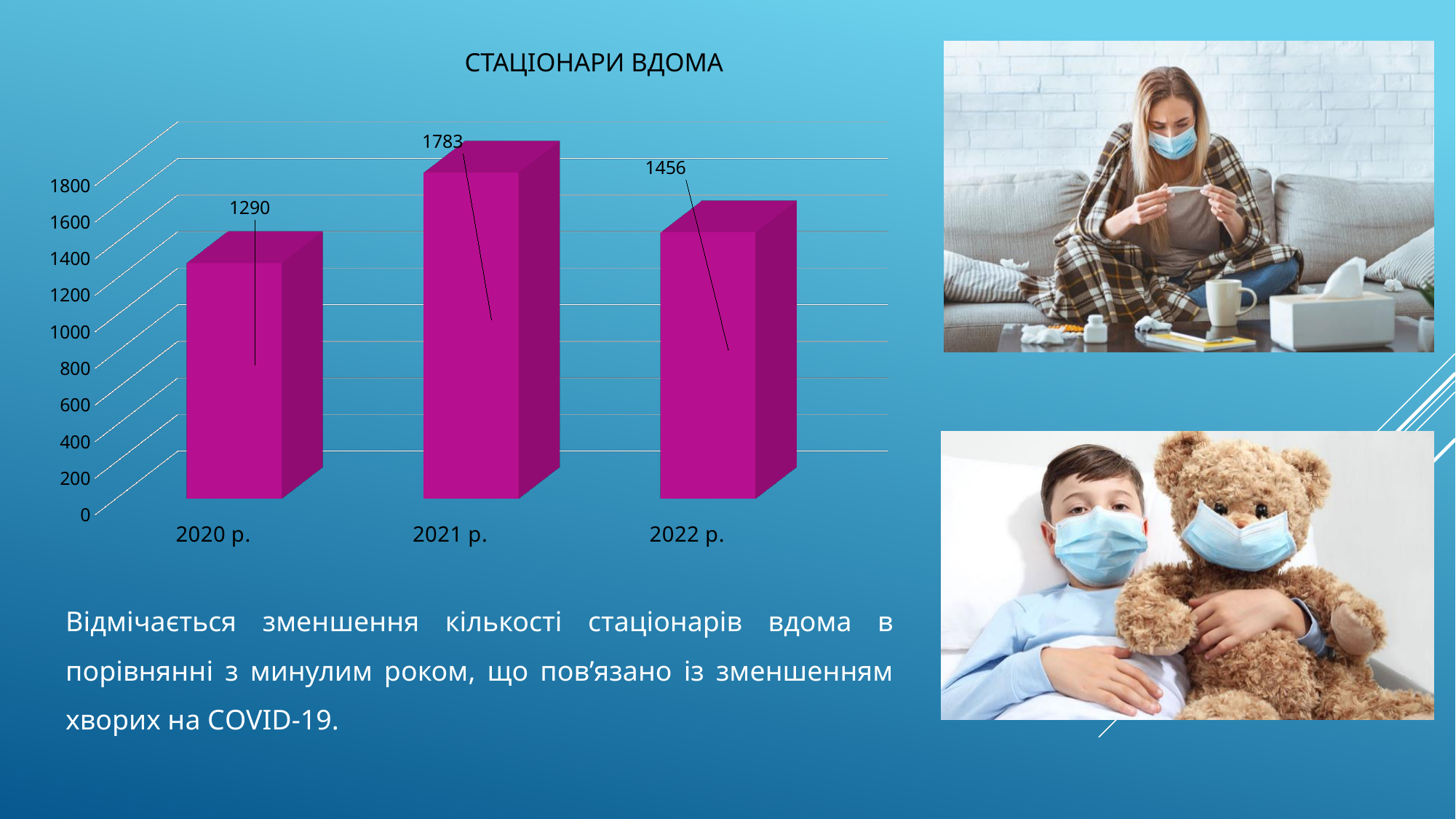
How many years are shown in the chart? 3 What is the value for 2021 р. in the chart? 1783 Which is larger, the value for 2022 р. or the value for 2020 р.? 2022 р. Which year has the lowest value in the chart? 2020 р. What is the difference between the values for 2021 р. and 2022 р.? 327 What is the value for 2022 р. in the chart? 1456 What is the difference between the values for 2021 р. and 2020 р.? 493 Which year has the highest value in the chart? 2021 р. What kind of chart is shown on the slide? bar chart What is the title of the chart? СТАЦІОНАРИ ВДОМА Is the value for 2020 р. greater or less than 1400? less What is the value for 2020 р. in the chart? 1290